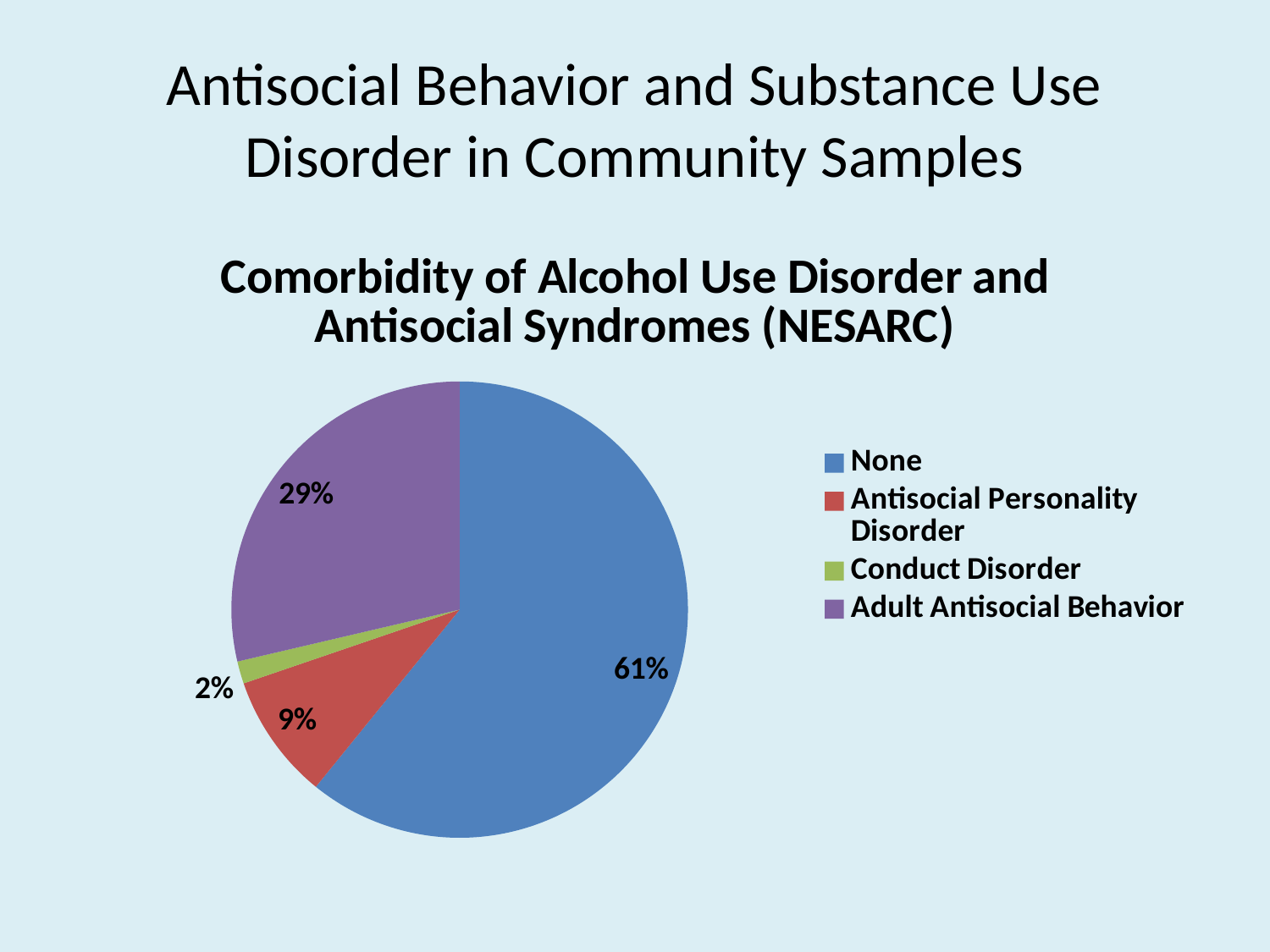
What share of the pie is Adult Antisocial Behavior? 29% What is the difference in percentage points between the None slice and the Adult Antisocial Behavior slice? 32 Which is larger, the Antisocial Personality Disorder slice or the Adult Antisocial Behavior slice? Adult Antisocial Behavior Which category has the largest slice of the pie? None What share of the pie is labelled None? 61% What is the chart's title? Comorbidity of Alcohol Use Disorder and Antisocial Syndromes (NESARC) What share of the pie is Antisocial Personality Disorder? 9% What colour is the Conduct Disorder slice? green What kind of chart is shown on the slide? pie chart How many categories does the pie chart show? 4 Which category has the smallest slice of the pie? Conduct Disorder